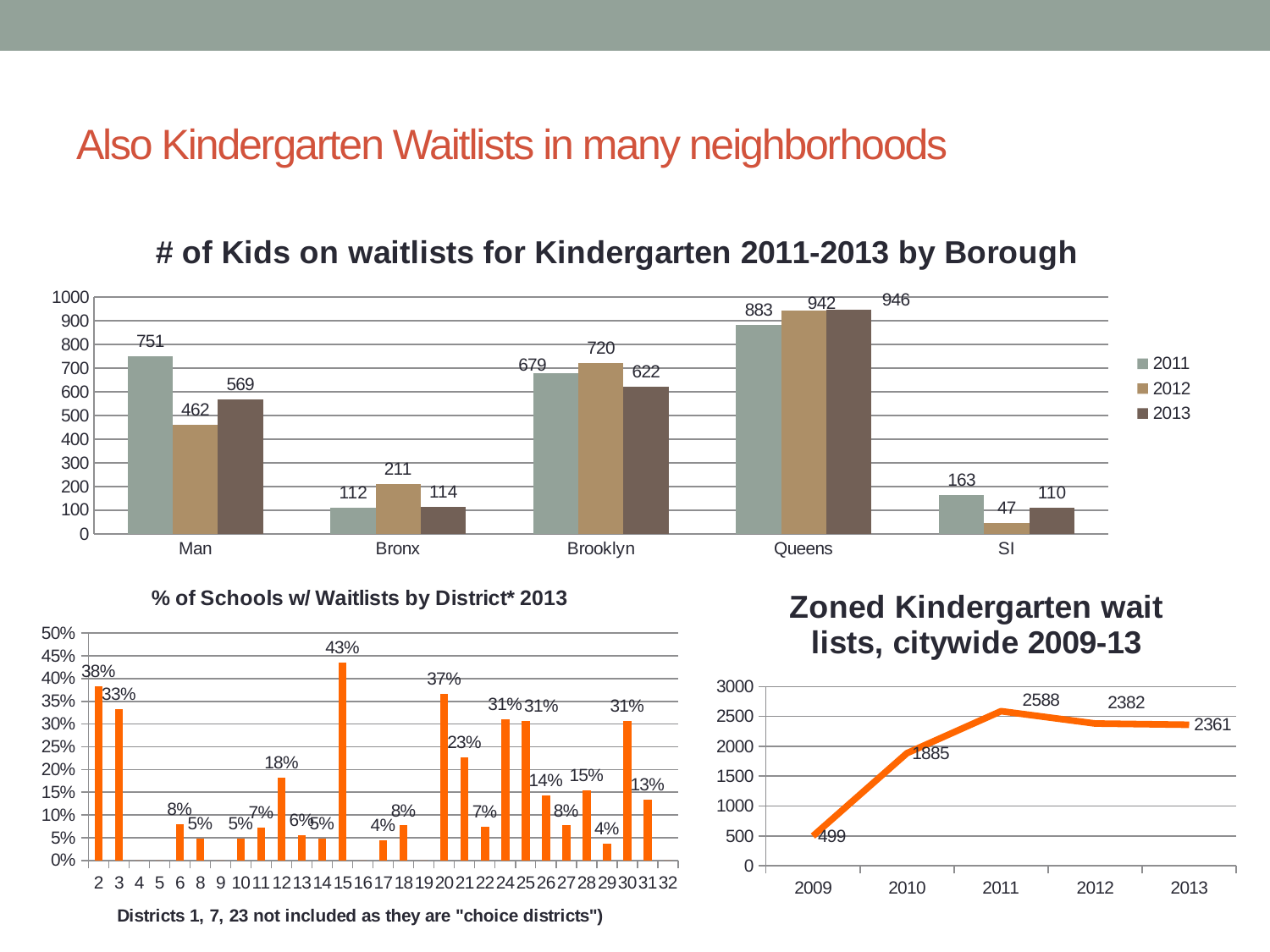
In the '# of Kids on waitlists for Kindergarten 2011-2013 by Borough' chart, what is the difference between the 2011 and 2012 values for Man? 289 In the '# of Kids on waitlists for Kindergarten 2011-2013 by Borough' chart, what is the 2012 value for SI? 47 What kind of chart is 'Zoned Kindergarten wait lists, citywide 2009-13'? Line chart In the 'Zoned Kindergarten wait lists, citywide 2009-13' chart, what is the difference between the 2010 and 2009 values? 1386 In the '% of Schools w/ Waitlists by District* 2013' chart, what is the value for district 20? 37% In the '# of Kids on waitlists for Kindergarten 2011-2013 by Borough' chart, which borough has the highest 2011 value? Queens How many boroughs are shown on the x axis of the '# of Kids on waitlists for Kindergarten 2011-2013 by Borough' chart? 5 In the 'Zoned Kindergarten wait lists, citywide 2009-13' chart, what is the value for 2011? 2588 In the '% of Schools w/ Waitlists by District* 2013' chart, which district has the highest value? 15 How many series does the legend list in the '# of Kids on waitlists for Kindergarten 2011-2013 by Borough' chart? 3 In the '# of Kids on waitlists for Kindergarten 2011-2013 by Borough' chart, how many kids were on waitlists in Queens in 2013? 946 In the '# of Kids on waitlists for Kindergarten 2011-2013 by Borough' chart, which is larger: Brooklyn in 2012 or Brooklyn in 2013? Brooklyn in 2012